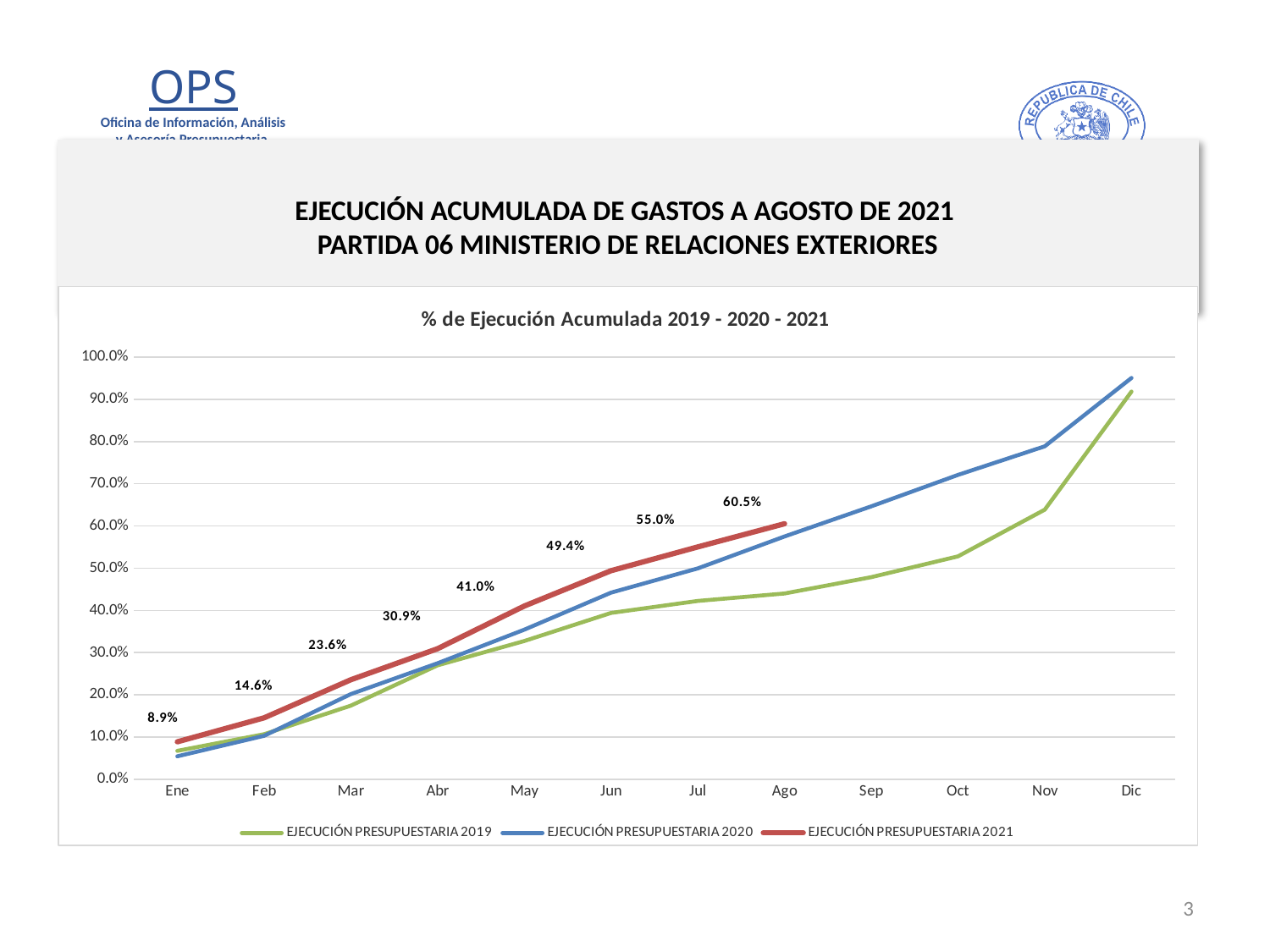
How many months are shown on the x axis? 12 What kind of chart is shown on the slide? Line chart What is the difference between the 2021 values for Mar and Feb? 9.0 percentage points Is the value for EJECUCIÓN PRESUPUESTARIA 2019 in Sep greater or less than 50.0%? less Is the value for EJECUCIÓN PRESUPUESTARIA 2020 in Dic greater or less than 90.0%? greater What is the value of EJECUCIÓN PRESUPUESTARIA 2021 in Ago? 60.5% Does the EJECUCIÓN PRESUPUESTARIA 2021 series rise or fall from Ene to Ago? Rises What is the value of EJECUCIÓN PRESUPUESTARIA 2021 in Ene? 8.9% What is the value of EJECUCIÓN PRESUPUESTARIA 2021 in May? 41.0% In Nov, which series is higher: EJECUCIÓN PRESUPUESTARIA 2019 or EJECUCIÓN PRESUPUESTARIA 2020? EJECUCIÓN PRESUPUESTARIA 2020 How many series does the legend list? 3 By how many percentage points does the 2021 series increase from Jul to Ago? 5.5 percentage points